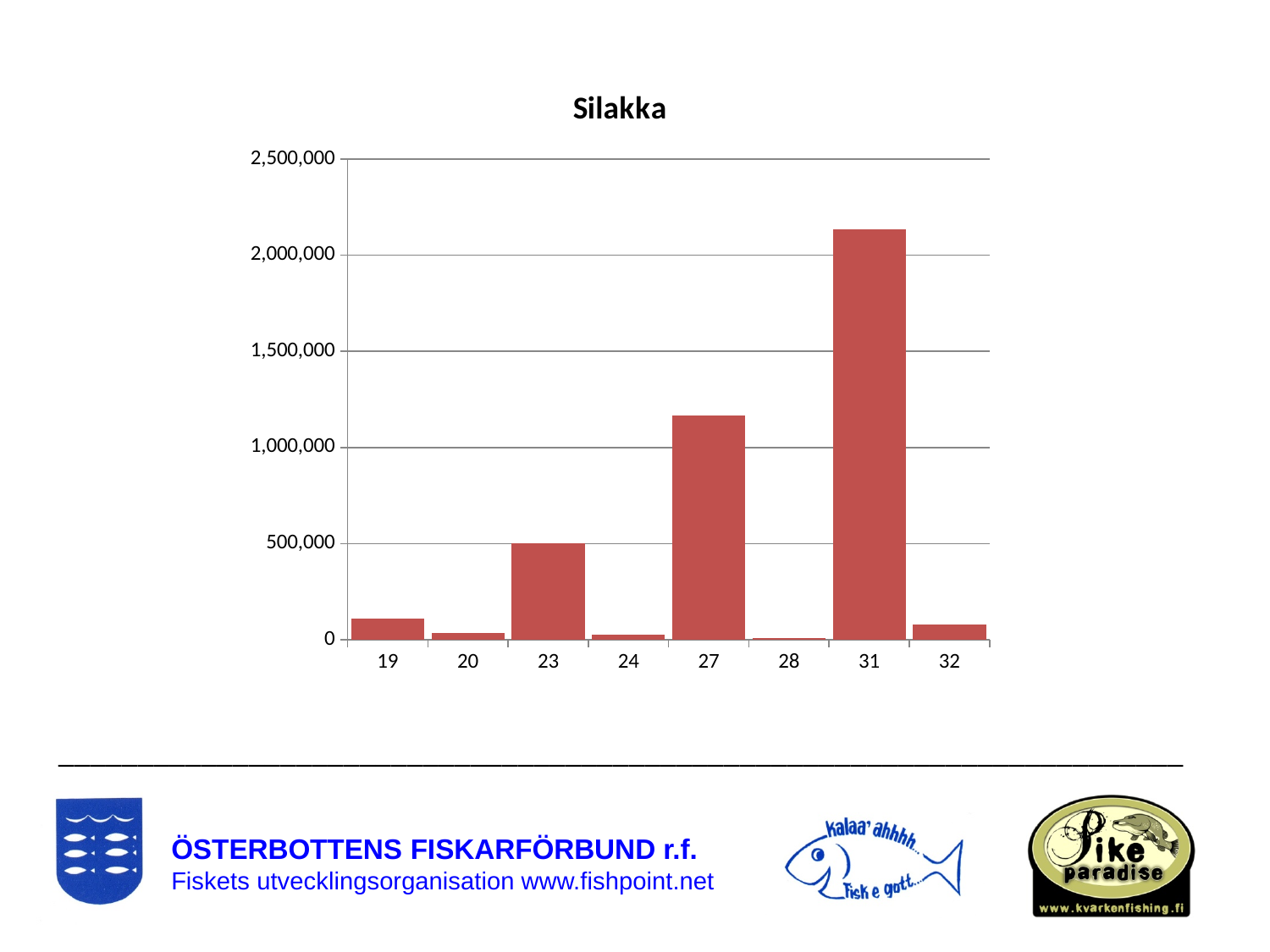
Which has a larger value, category 27 or category 31? 31 Which category has the highest value in the chart? 31 Is the value for category 31 greater or less than 2,000,000? greater What kind of chart is shown on the slide? bar chart What is the title of the chart? Silakka What colour are the bars in the chart? red Is the value for category 27 greater or less than 1,000,000? greater How many categories are shown on the x axis of the chart? 8 Is the value for category 19 greater or less than 500,000? less Which has a larger value, category 19 or category 32? 19 Which category has the lowest value in the chart? 28